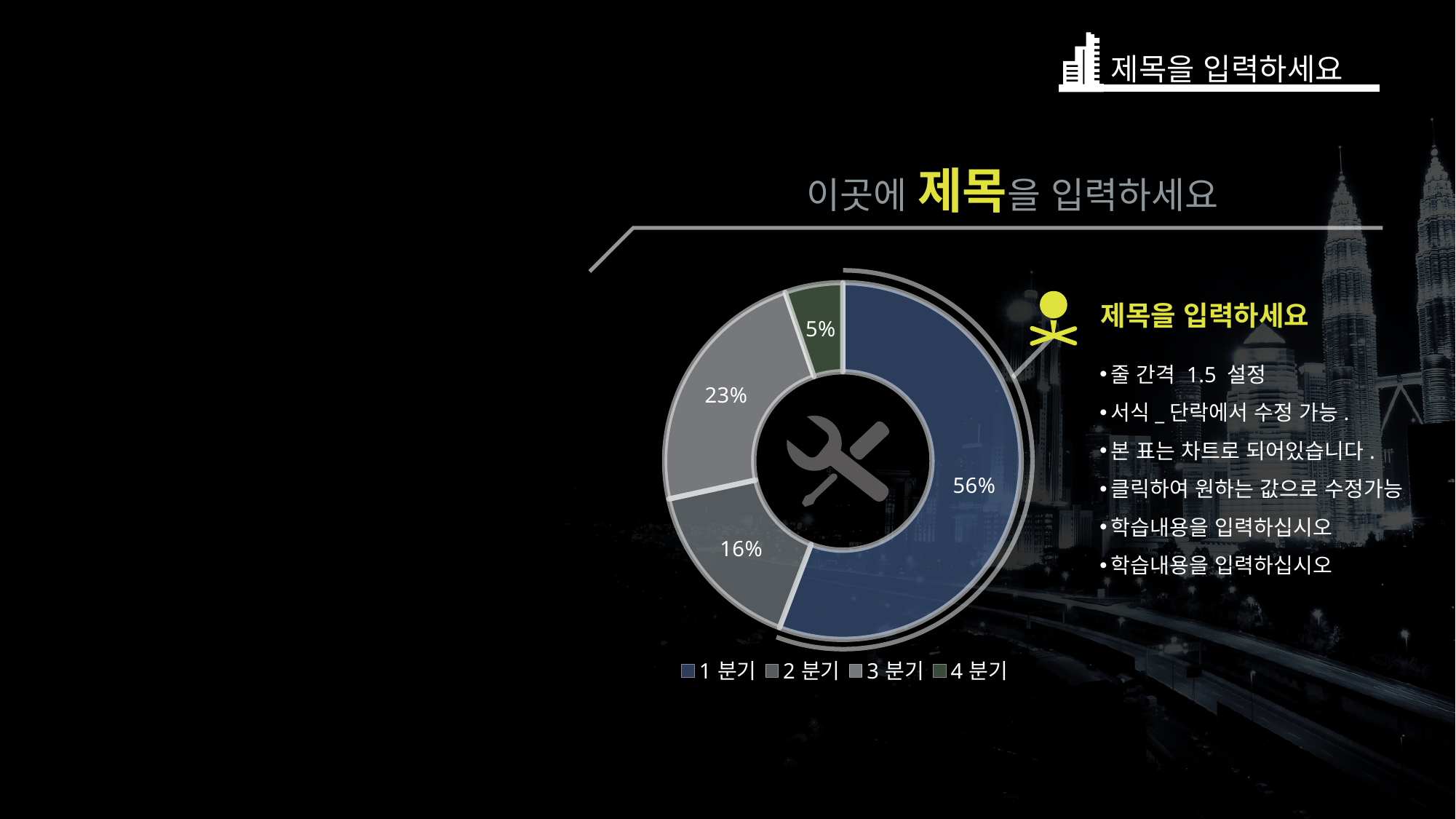
Which category has the largest slice? 1 분기 What is the difference in percentage points between the 1 분기 and 3 분기 slices? 33 What percentage does the 1 분기 slice show? 56% What percentage does the 3 분기 slice show? 23% What percentage does the 4 분기 slice show? 5% Which category has the smallest slice? 4 분기 What kind of chart is shown on the slide? Doughnut (pie) chart How many entries does the legend list? 4 What percentage does the 2 분기 slice show? 16% How many slices does the chart have? 4 Which slice is larger, 2 분기 or 3 분기? 3 분기 What colour is the 1 분기 slice? Blue